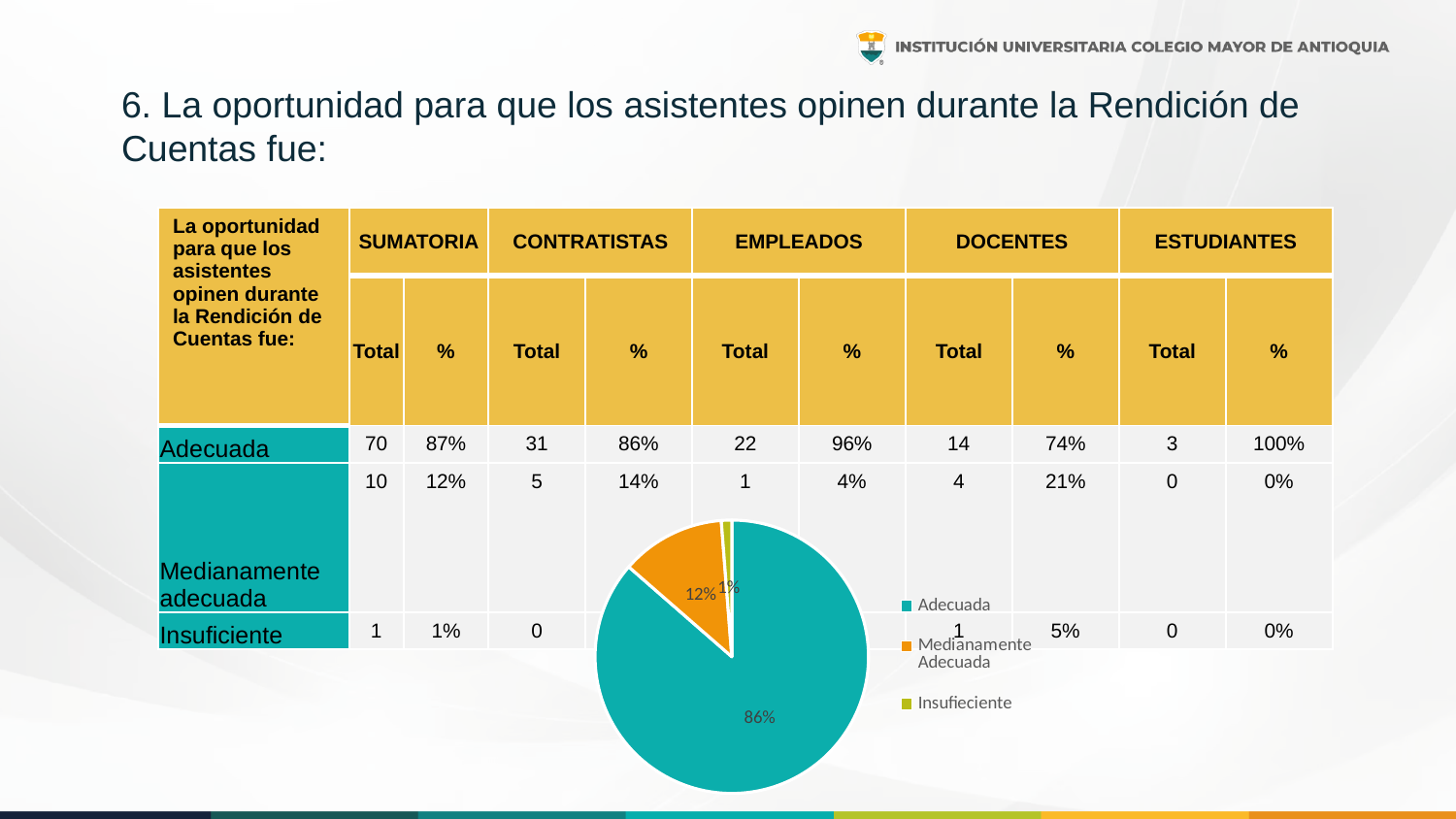
In the pie chart, what is the difference in percentage points between Adecuada and Medianamente Adecuada? 74 percentage points In the pie chart, what percentage is shown for Adecuada? 86% In the pie chart, what percentage is shown for Insufieciente? 1% What kind of chart is shown on the slide? pie chart How many entries does the pie chart's legend list? 3 In the pie chart, which is larger: Medianamente Adecuada or Insufieciente? Medianamente Adecuada Which category has the largest slice in the pie chart? Adecuada What colour is the Adecuada slice in the pie chart? teal How many slices does the pie chart have? 3 What share of the pie does the Medianamente Adecuada slice represent? 12% Which category has the smallest slice in the pie chart? Insufieciente In the pie chart, what percentage is shown for Medianamente Adecuada? 12%